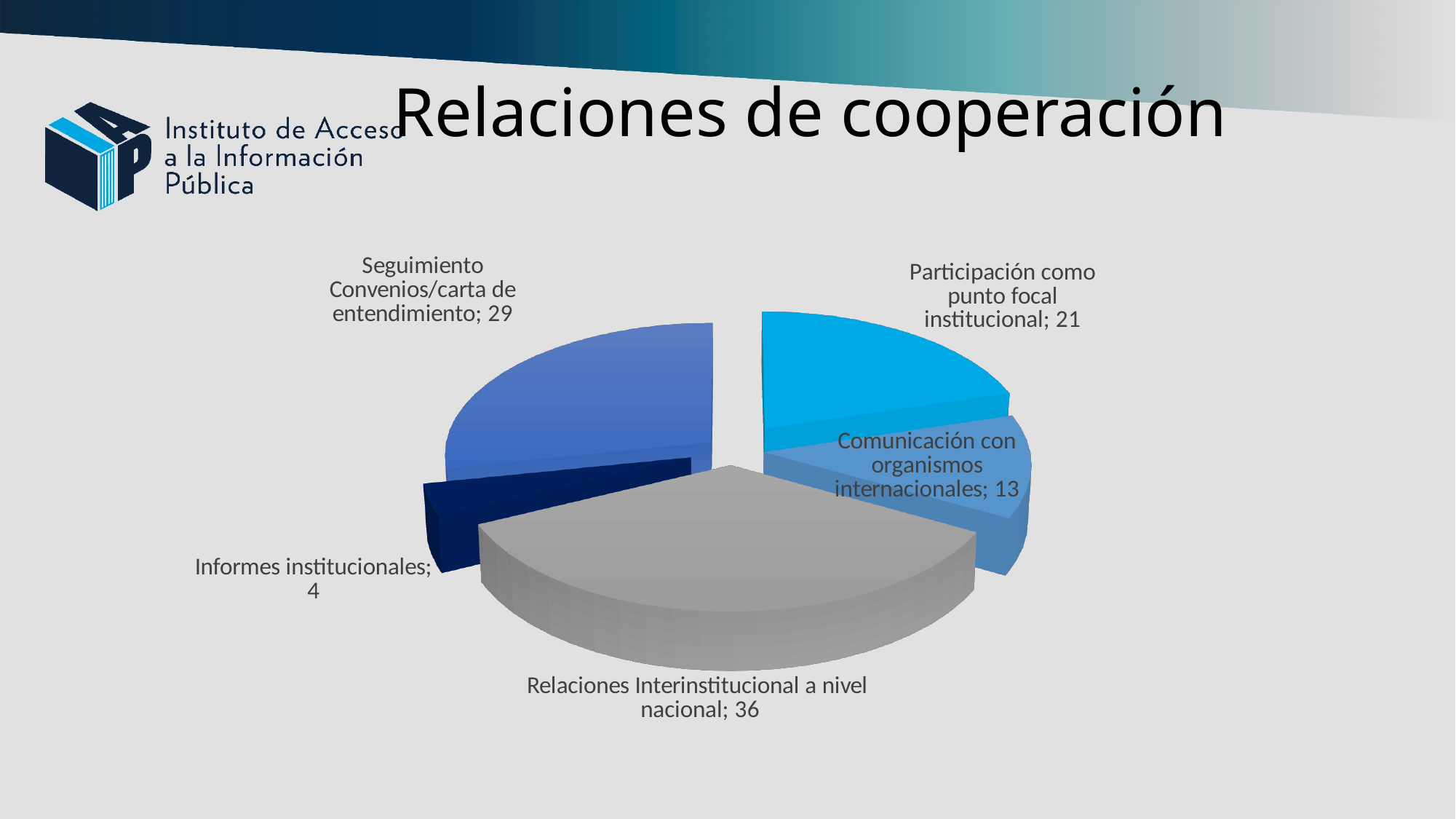
What is the title of the chart? Relaciones de cooperación What is the value for Participación como punto focal institucional? 21 What is the difference between Relaciones Interinstitucional a nivel nacional and Seguimiento Convenios/carta de entendimiento? 7 How many categories are shown in the pie chart? 5 Which is larger, Participación como punto focal institucional or Comunicación con organismos internacionales? Participación como punto focal institucional Which category has the largest slice? Relaciones Interinstitucional a nivel nacional What kind of chart is shown on the slide? Pie chart What is the value for Relaciones Interinstitucional a nivel nacional? 36 What is the value for Comunicación con organismos internacionales? 13 Which category has the smallest slice? Informes institucionales What is the value for Seguimiento Convenios/carta de entendimiento? 29 What is the value for Informes institucionales? 4